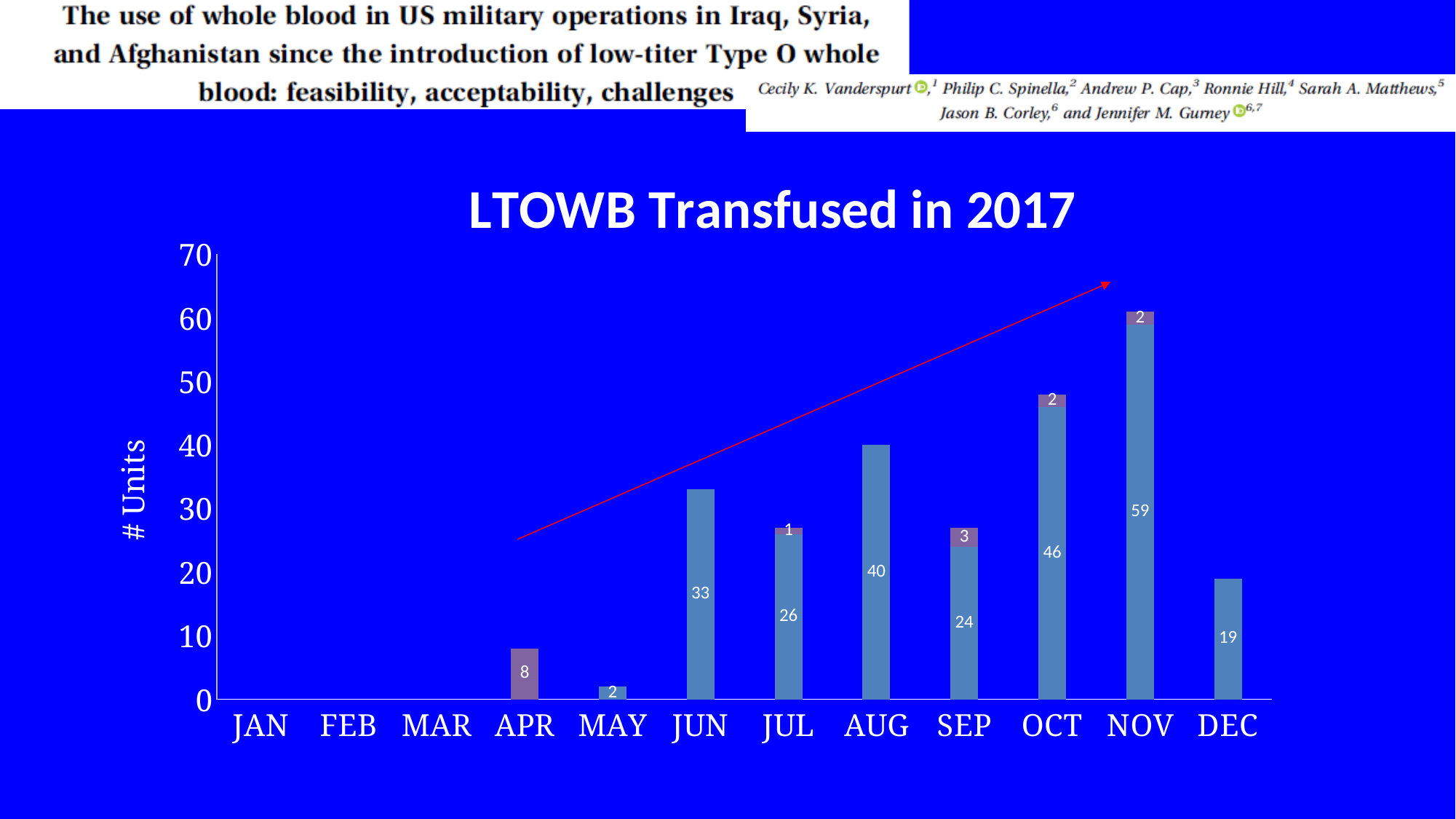
What is the value labelled on the blue bar for JUN? 33 What is the value labelled on the bar for APR? 8 What is the difference between the blue bar values for AUG and JUN? 7 Is the total bar for OCT greater or less than 40? greater What is the value labelled on the bar for DEC? 19 What is the total of the stacked bar for OCT? 48 Which month has the tallest bar? NOV What is the value labelled on the bar for AUG? 40 How many months are shown along the x axis of the chart? 12 What is the title of the chart? LTOWB Transfused in 2017 What kind of chart is shown on the slide? bar chart What is the total of the stacked bar for NOV? 61